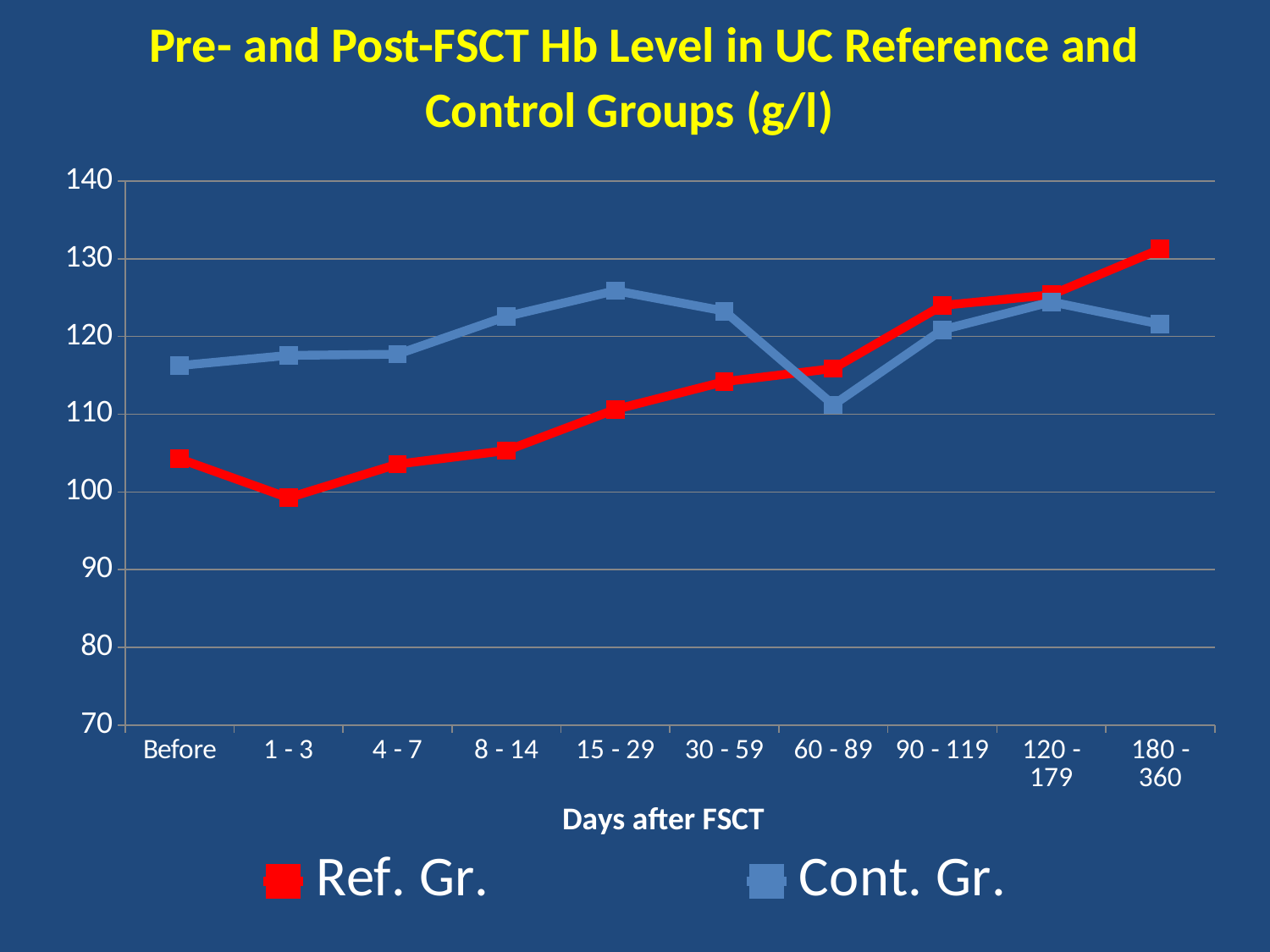
At which time point does the Cont. Gr. line reach its highest value? 15 - 29 At which time point does the Cont. Gr. line reach its lowest value? 60 - 89 Is the Ref. Gr. value at 180 - 360 greater or less than 120? greater At 180 - 360 days, which group has the higher Hb level, Ref. Gr. or Cont. Gr.? Ref. Gr. At the Before time point, which group has the higher Hb level, Ref. Gr. or Cont. Gr.? Cont. Gr. At which time point does the Ref. Gr. line reach its lowest value? 1 - 3 At which time point does the Ref. Gr. line reach its highest value? 180 - 360 How many time-point categories are shown along the x axis? 10 Is the Cont. Gr. value at 60 - 89 greater or less than 120? less Is the Ref. Gr. value at Before greater or less than 110? less How many series does the legend list? 2 What kind of chart is shown on the slide? line chart